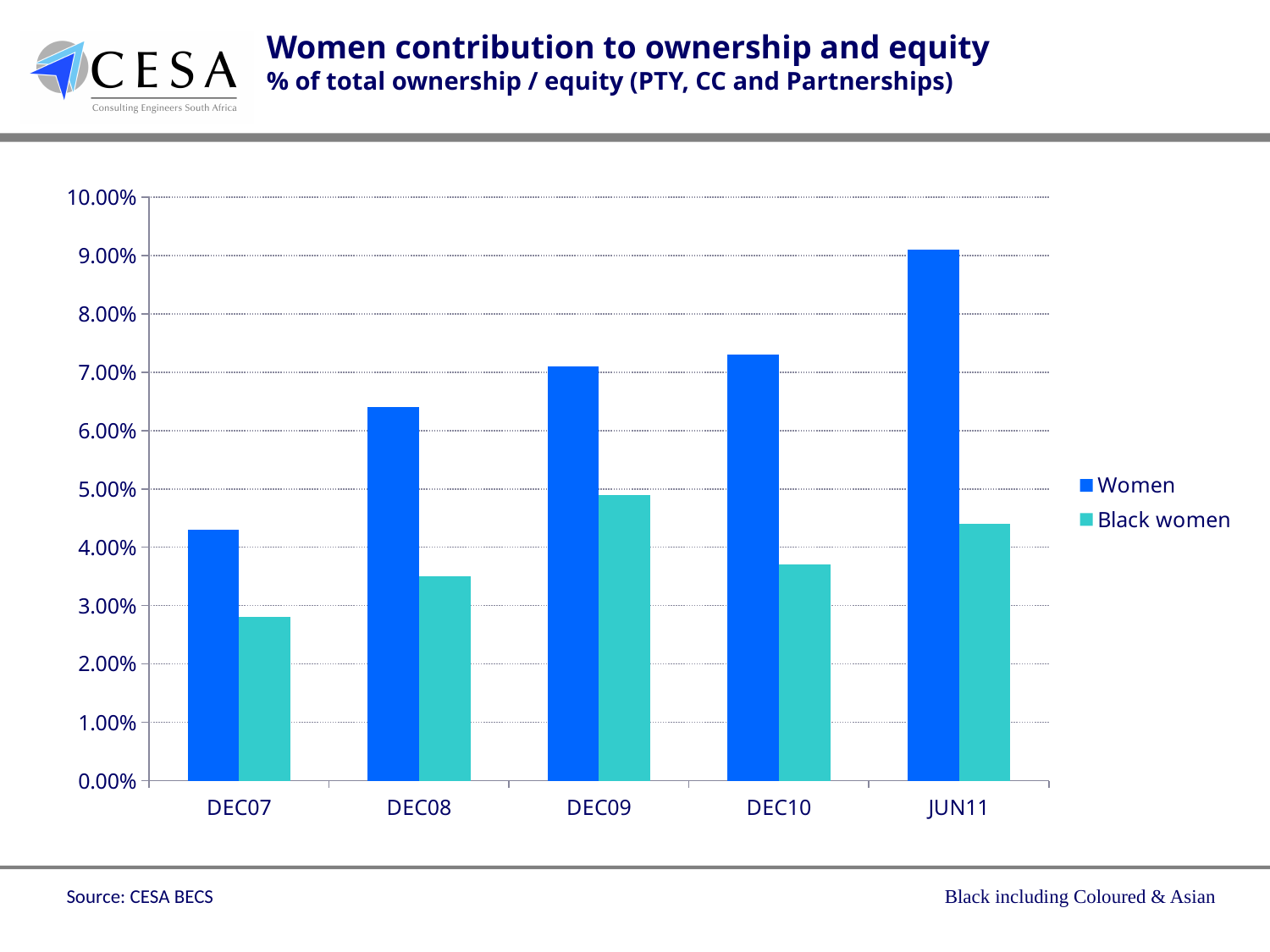
Which is larger for Black women: DEC10 or JUN11? JUN11 Is the value for Black women in DEC10 greater or less than 4.00%? less Does the Women series rise or fall from DEC07 to JUN11? Rise Is the value for Women in DEC07 greater or less than 4.00%? greater In which period is the Black women series highest? DEC09 How many series does the legend list? 2 In which period is the Women series lowest? DEC07 What kind of chart is shown on the slide? Bar chart In which period is the Women series highest? JUN11 Is the value for Black women in DEC07 greater or less than 3.00%? less How many time periods are shown on the x axis? 5